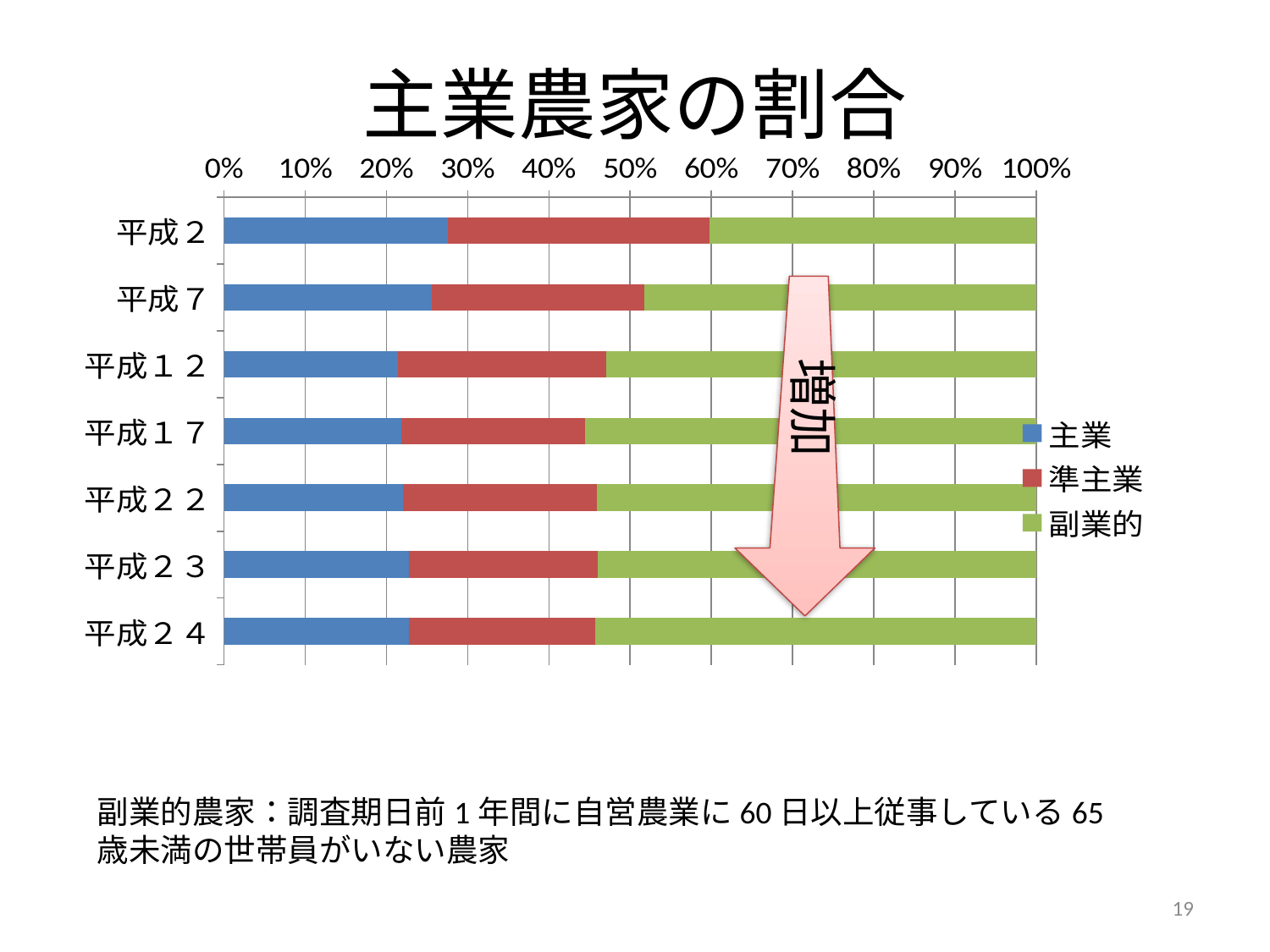
Does the 副業的 share rise or fall from 平成２ to 平成２４? rise What kind of chart is shown on the slide? stacked bar chart Is the 副業的 share larger in 平成２ or in 平成２４? 平成２４ What is the title of the chart? 主業農家の割合 Which year has the largest 主業 share? 平成２ What are the three series listed in the legend? 主業, 準主業, 副業的 How many series does the legend list? 3 Is the 副業的 share for 平成２４ greater or less than 50%? greater Is the 主業 share for 平成２ greater or less than 20%? greater Does the 主業 share rise or fall from 平成２ to 平成２４? fall How many years (categories) are shown on the chart? 7 Is the 主業 share for 平成１２ greater or less than 30%? less